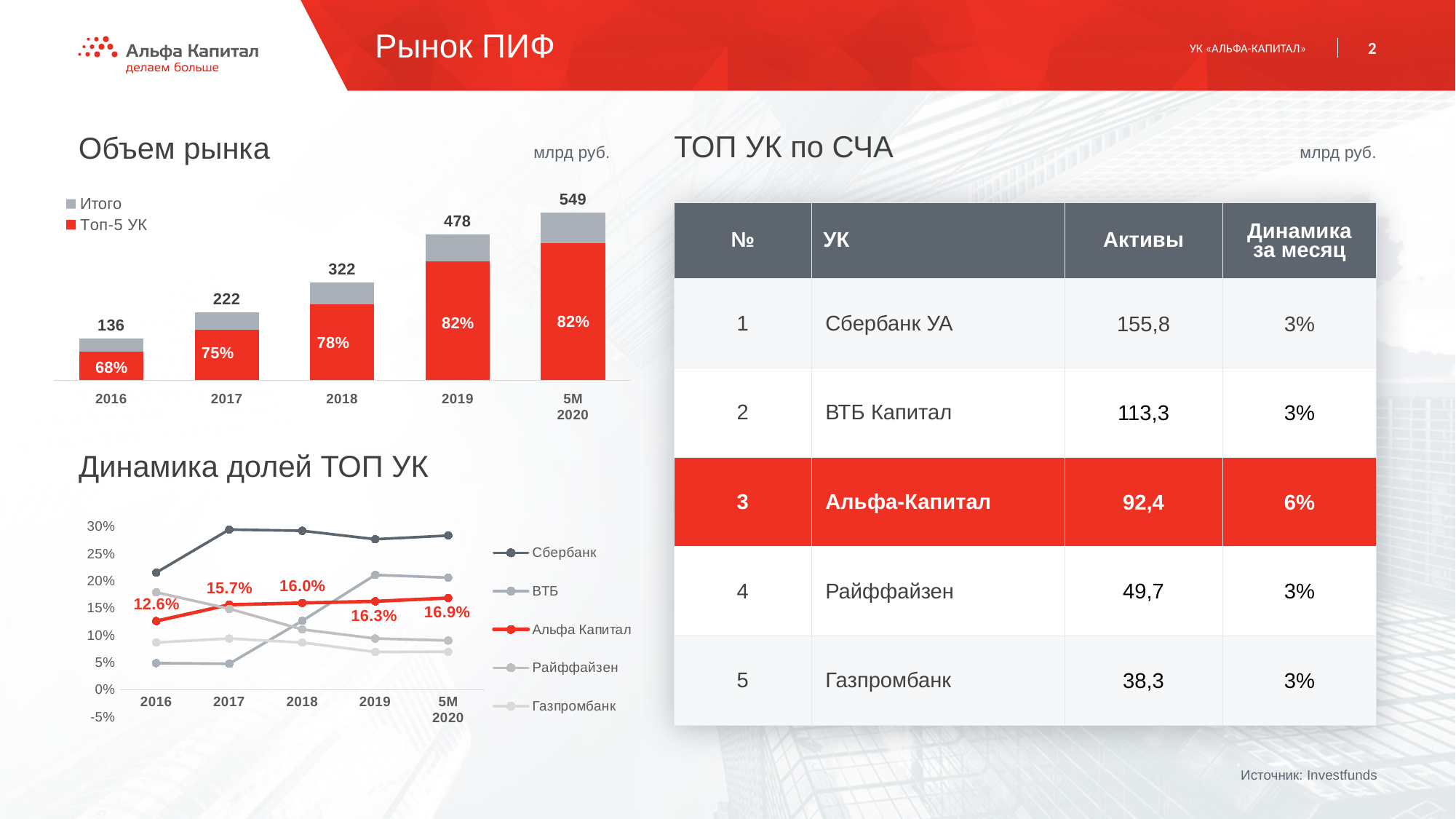
How many series does the legend of the 'Динамика долей ТОП УК' chart list? 5 In the 'Динамика долей ТОП УК' chart, is the value for Сбербанк in 2017 greater or less than 25%? greater In the 'Объем рынка' chart, which period has the highest total value? 5M 2020 In the 'Объем рынка' chart, what is the total market volume for 2019? 478 In the 'Объем рынка' chart, what share is labelled on the Топ-5 УК segment for 2016? 68% In the 'Динамика долей ТОП УК' chart, which series has the highest value in 2019? Сбербанк How many periods are shown on the x axis of the 'Объем рынка' chart? 5 In the 'Объем рынка' chart, what is the difference between the totals for 5M 2020 and 2019? 71 In the 'Динамика долей ТОП УК' chart, is the value for Альфа Капитал larger in 2016 or in 5M 2020? 5M 2020 In the 'Объем рынка' chart, do the total values rise or fall from 2016 to 5M 2020? rise In the 'Динамика долей ТОП УК' chart, what is the value for Альфа Капитал in 2017? 15.7% What kind of chart is 'Объем рынка'? bar chart